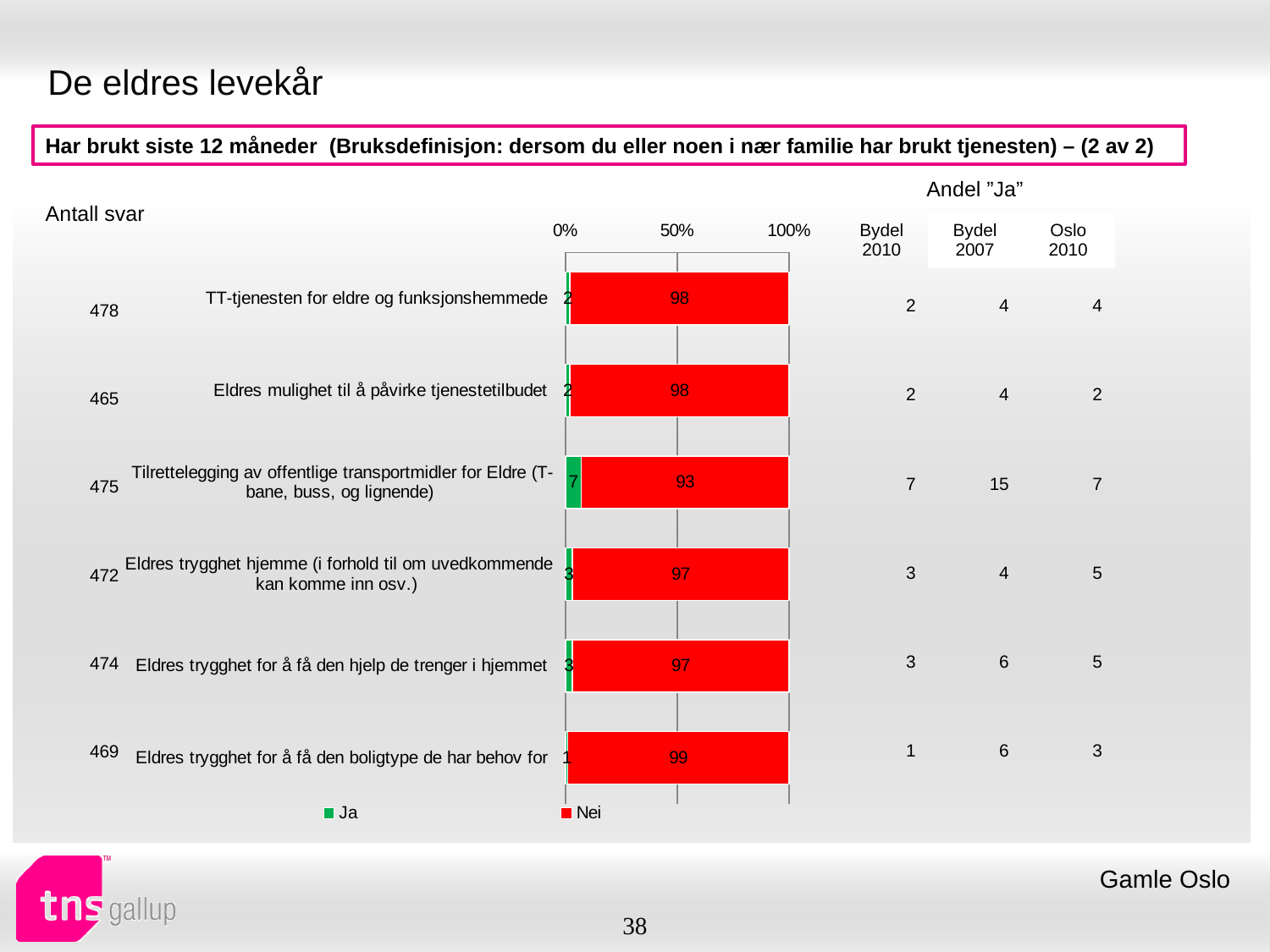
What is the "Nei" value for "TT-tjenesten for eldre og funksjonshemmede"? 98 What is the difference between the "Nei" values for "Eldres trygghet for å få den boligtype de har behov for" and "Tilrettelegging av offentlige transportmidler for Eldre (T-bane, buss, og lignende)"? 6 What kind of chart is shown on the slide? bar chart How many categories are plotted in the chart? 6 What is the total of the stacked bar for "Eldres trygghet for å få den hjelp de trenger i hjemmet"? 100 Which colour represents the "Nei" series in the chart? red Which category has the lowest "Nei" value? Tilrettelegging av offentlige transportmidler for Eldre (T-bane, buss, og lignende) What is the "Ja" value for "Tilrettelegging av offentlige transportmidler for Eldre (T-bane, buss, og lignende)"? 7 Which is larger: the "Ja" value for "Eldres trygghet hjemme (i forhold til om uvedkommende kan komme inn osv.)" or the "Ja" value for "TT-tjenesten for eldre og funksjonshemmede"? Eldres trygghet hjemme (i forhold til om uvedkommende kan komme inn osv.) What is the "Nei" value for "Eldres trygghet for å få den boligtype de har behov for"? 99 Which category has the highest "Ja" value? Tilrettelegging av offentlige transportmidler for Eldre (T-bane, buss, og lignende) How many series does the chart legend list? 2